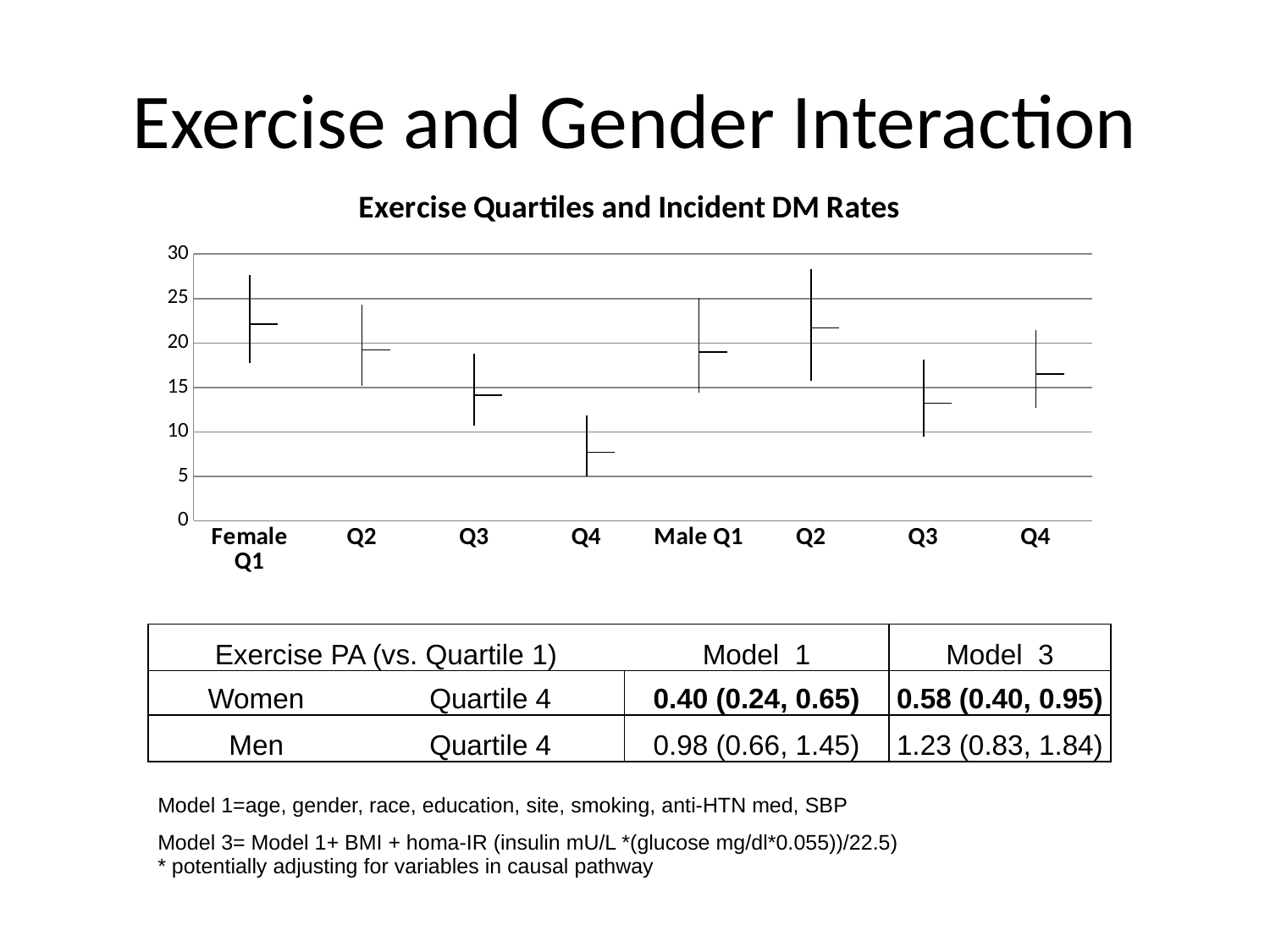
Do the values for the female quartiles rise or fall from Q1 to Q4? fall Is the value for Female Q1 greater or less than 20? greater Which is larger, the value for Male Q4 or the value for Female Q4? Male Q4 Is the value for Male Q2 greater or less than 20? greater Which category has the lowest value in the chart? Female Q4 Which is larger, the value for Female Q1 or the value for Female Q4? Female Q1 Is the value for Female Q4 greater or less than 10? less What is the title of the chart? Exercise Quartiles and Incident DM Rates What is the highest value shown on the y axis of the chart? 30 How many categories are shown on the x axis of the chart? 8